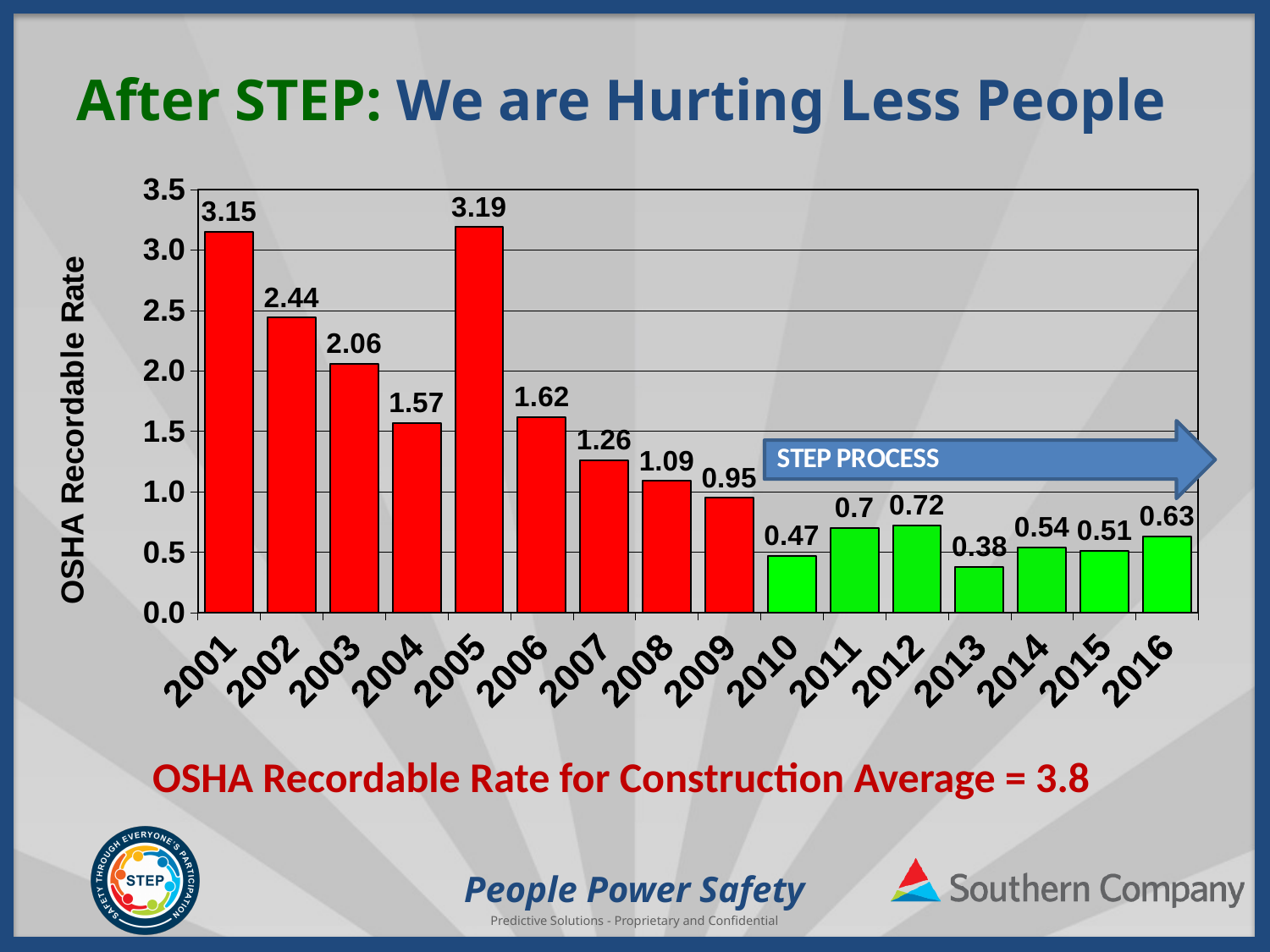
Which year has the lowest OSHA Recordable Rate? 2013 What is the OSHA Recordable Rate for 2013? 0.38 Do the OSHA Recordable Rate values generally rise or fall from 2001 to 2016? fall How many years are shown on the x axis of the chart? 16 Which year has the highest OSHA Recordable Rate? 2005 What is the difference between the OSHA Recordable Rate in 2001 and in 2016? 2.52 What kind of chart is shown on the slide? bar chart Is the OSHA Recordable Rate for 2009 greater or less than 1.0? less What colour are the bars for the years 2010 through 2016? green Which year has a higher OSHA Recordable Rate, 2002 or 2006? 2002 What is the OSHA Recordable Rate for 2005? 3.19 What is the OSHA Recordable Rate for 2010? 0.47